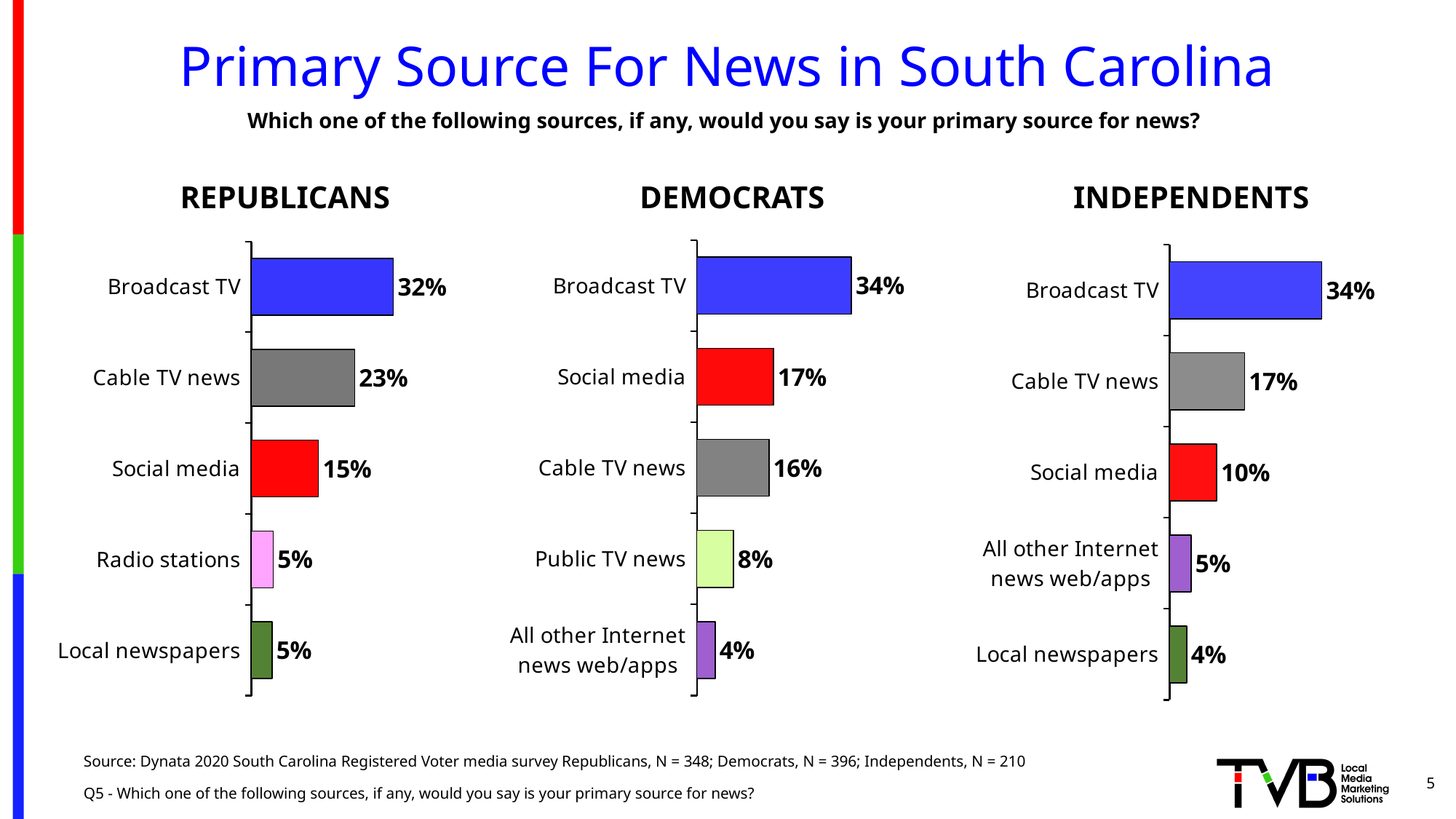
In the INDEPENDENTS chart, which source has the lowest percentage? Local newspapers In the REPUBLICANS chart, what colour is the Social media bar? Red In the REPUBLICANS chart, what percentage is shown for Cable TV news? 23% In the REPUBLICANS chart, what is the difference between Broadcast TV and Cable TV news? 9% How many sources are shown in the REPUBLICANS chart? 5 In the INDEPENDENTS chart, what percentage is shown for All other Internet news web/apps? 5% What is the title of the slide? Primary Source For News in South Carolina In the DEMOCRATS chart, which source has the highest percentage? Broadcast TV What kind of chart is used for the DEMOCRATS data? Bar chart In the DEMOCRATS chart, what percentage is shown for Social media? 17% In the INDEPENDENTS chart, which is larger, Cable TV news or Social media? Cable TV news In the DEMOCRATS chart, what is the difference between Social media and Public TV news? 9%